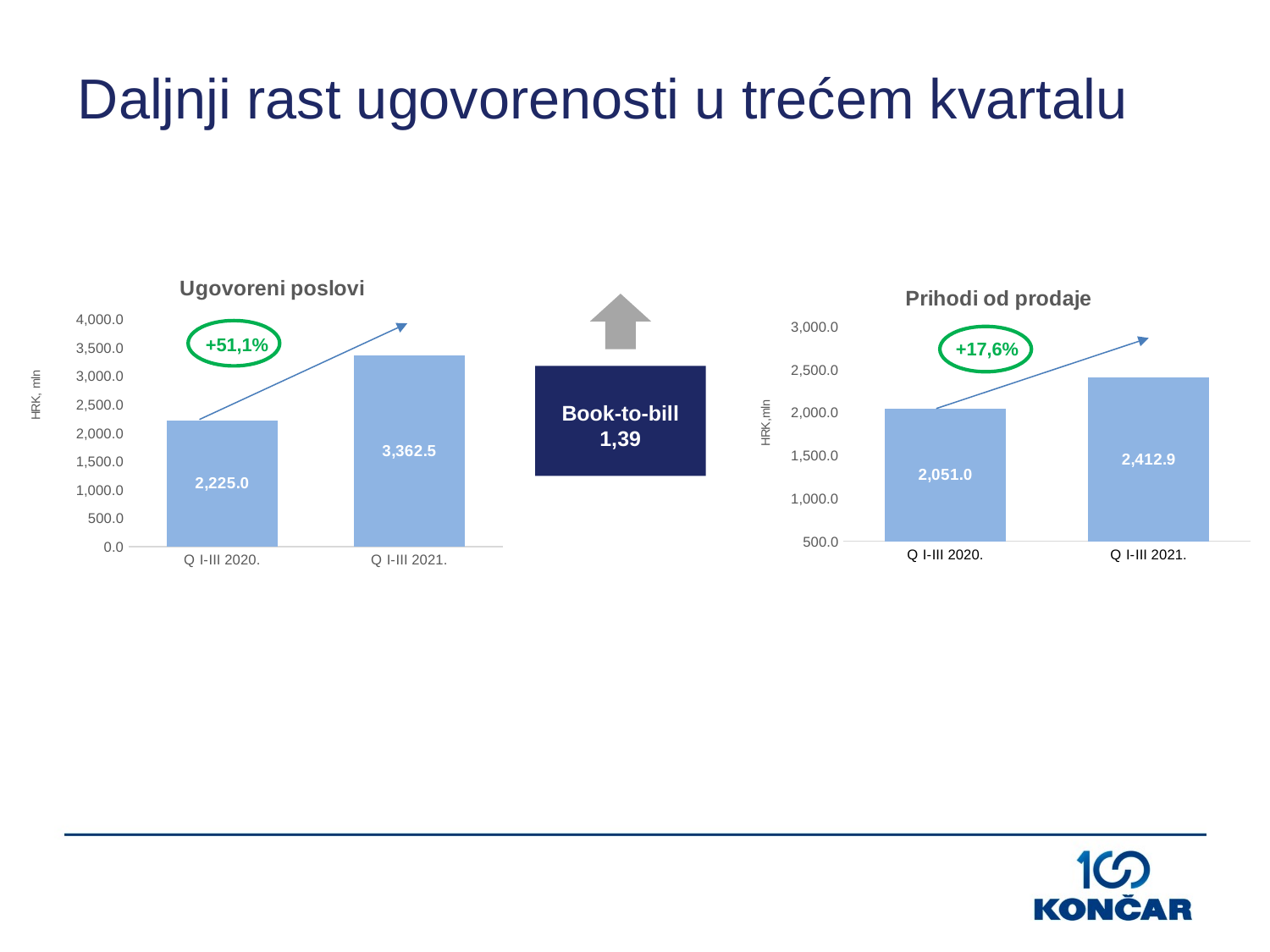
In the 'Ugovoreni poslovi' chart, what is the difference between the Q I-III 2021. and Q I-III 2020. values? 1,137.5 In the 'Prihodi od prodaje' chart, what is the value for Q I-III 2021.? 2,412.9 In the 'Ugovoreni poslovi' chart, which period has the higher value? Q I-III 2021. In the 'Prihodi od prodaje' chart, which period has the lower value? Q I-III 2020. In the 'Ugovoreni poslovi' chart, what is the value for Q I-III 2021.? 3,362.5 In the 'Ugovoreni poslovi' chart, do the values rise or fall from Q I-III 2020. to Q I-III 2021.? Rise What type of chart is the 'Prihodi od prodaje' chart? Bar chart What percentage change is shown in the green circle on the 'Prihodi od prodaje' chart? +17,6% In the 'Prihodi od prodaje' chart, what is the difference between the Q I-III 2021. and Q I-III 2020. values? 361.9 How many categories are shown on the x axis of the 'Prihodi od prodaje' chart? 2 In the 'Prihodi od prodaje' chart, what is the value for Q I-III 2020.? 2,051.0 In the 'Ugovoreni poslovi' chart, what is the value for Q I-III 2020.? 2,225.0